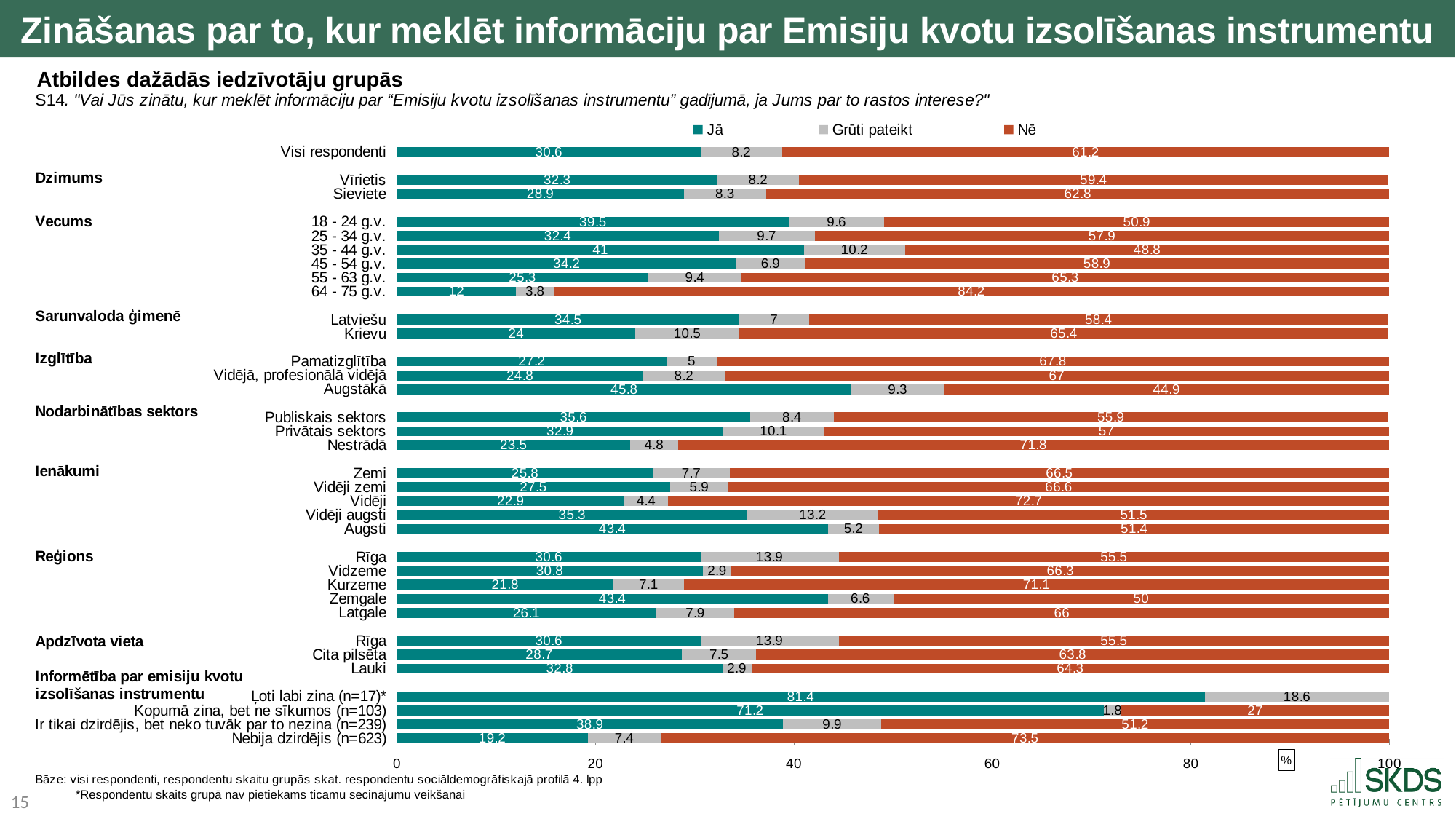
How many series does the legend list? 3 What kind of chart is shown on the slide? Stacked bar chart Among the regions (Reģions), which has the lowest "Jā" value? Kurzeme What is the difference between the "Jā" values for Vīrietis and Sieviete? 3.4 What is the "Jā" value for Visi respondenti? 30.6 What is the "Grūti pateikt" value for Augstākā (education)? 9.3 What is the total of the stacked bar for Visi respondenti? 100 What is the "Nē" value for the 64 - 75 g.v. age group? 84.2 Which has a larger "Nē" value, Latviešu or Krievu? Krievu What is the "Jā" value for Ļoti labi zina (n=17)*? 81.4 Among the age groups (Vecums), which has the highest "Jā" value? 35 - 44 g.v. Is the "Nē" value for Nestrādā greater or less than 60? greater